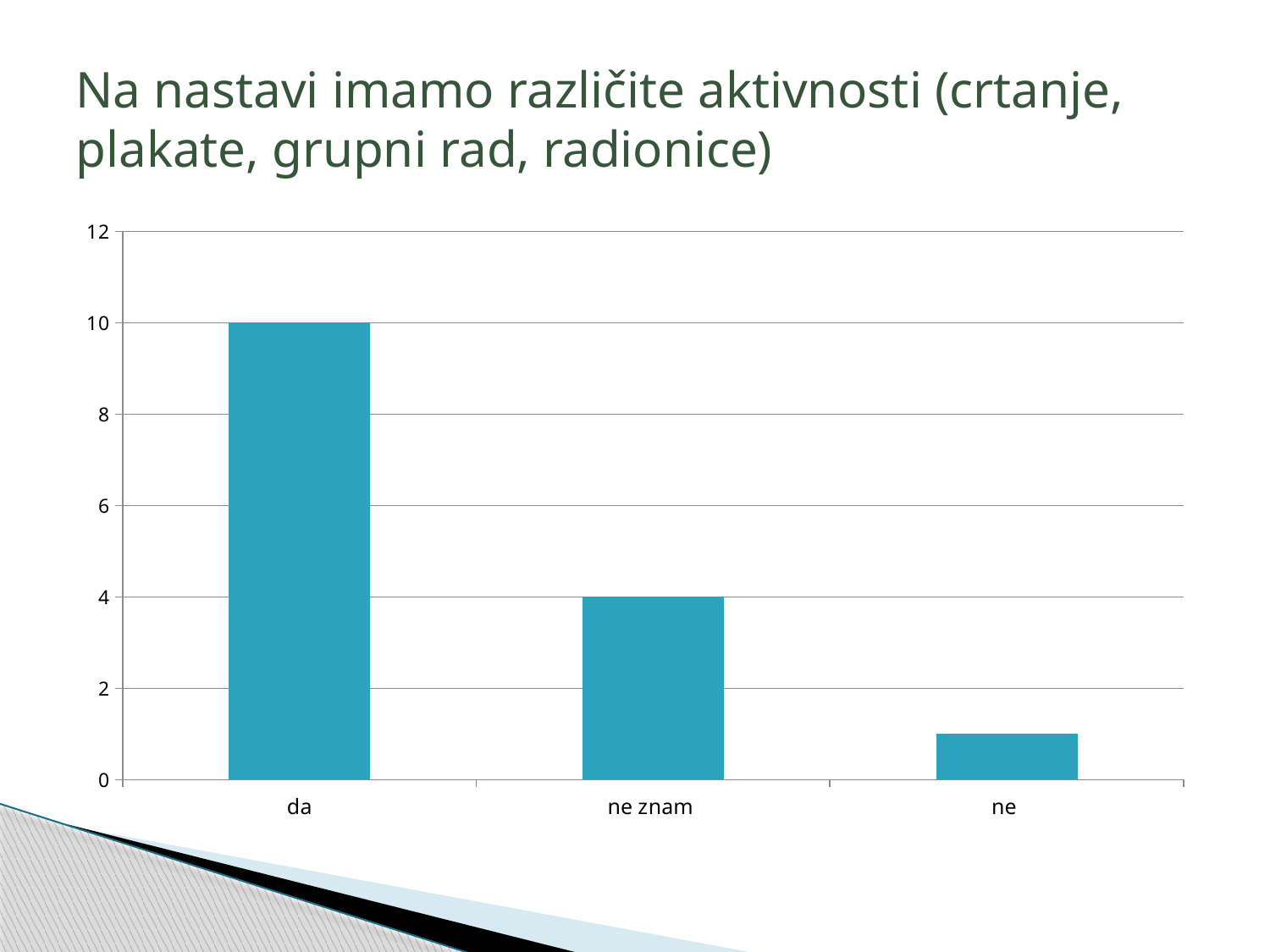
What is the value for "ne znam"? 4 How many categories are shown on the x axis? 3 What kind of chart is shown on the slide? bar chart What is the difference between the values for "da" and "ne znam"? 6 Is the value for "ne" greater or less than 2? less Is the value for "da" greater or less than 8? greater Do the values rise or fall from left to right along the x axis? fall What is the value for "da"? 10 Which is larger, the value for "ne znam" or the value for "ne"? ne znam What is the highest value shown on the vertical axis? 12 Which category has the highest value? da Which category has the lowest value? ne